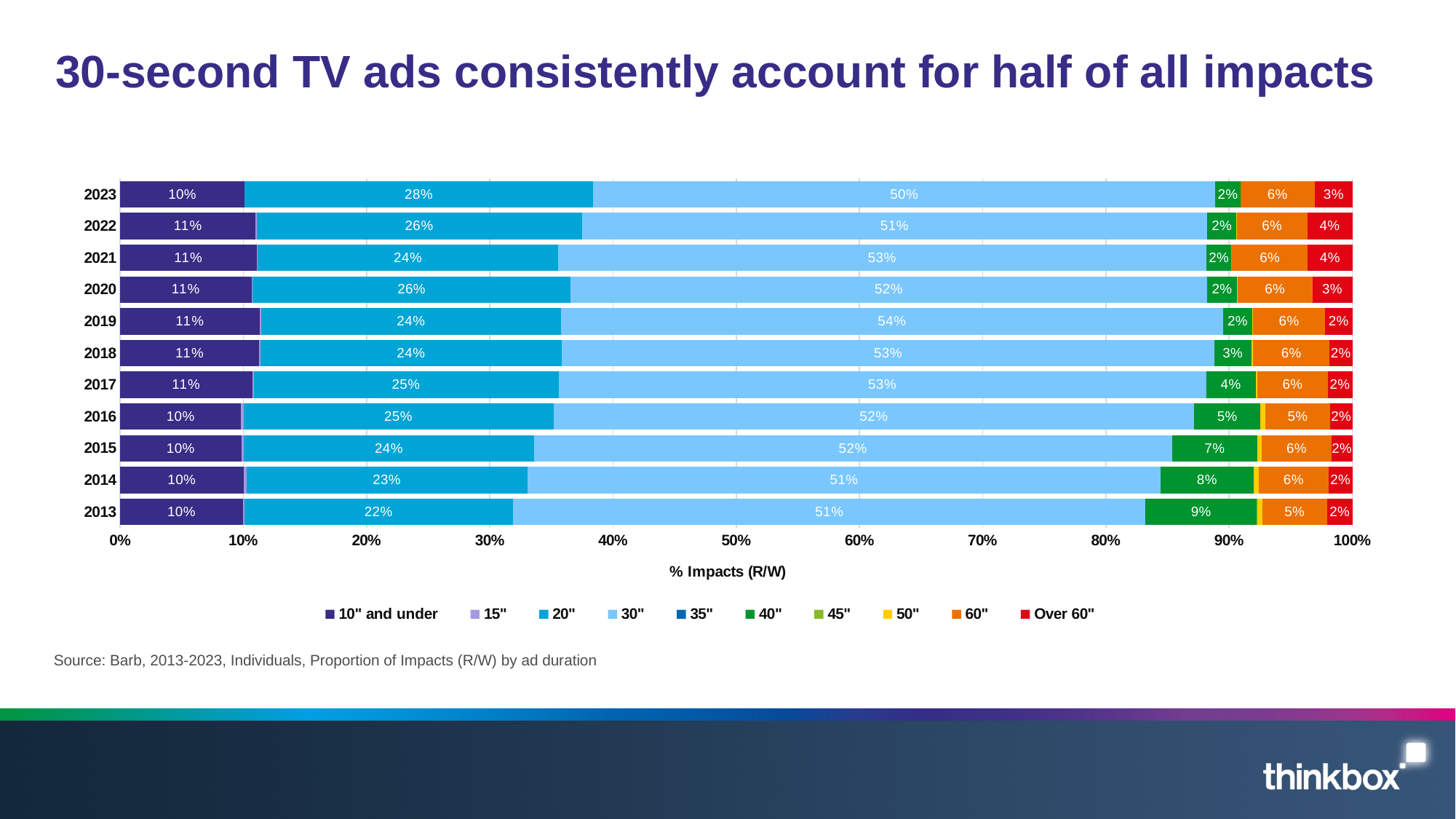
How many years are shown in the chart? 11 How many ad duration series does the legend list? 10 Which year had a larger share of impacts for 40" ads, 2014 or 2017? 2014 In which year did 30" ads have the highest share of impacts? 2019 By how many percentage points did the share of 20" ads in 2023 exceed that in 2013? 6 percentage points Did the share of impacts for 40" ads rise or fall from 2013 to 2023? Fall What was the share of impacts for 20" ads in 2013? 22% What percentage of impacts did 30" ads account for in 2023? 50% What was the share of impacts for ads over 60" in 2022? 4% What is the title of the horizontal axis? % Impacts (R/W) What type of chart is shown on the slide? Stacked bar chart In which year did 40" ads have the highest share of impacts? 2013